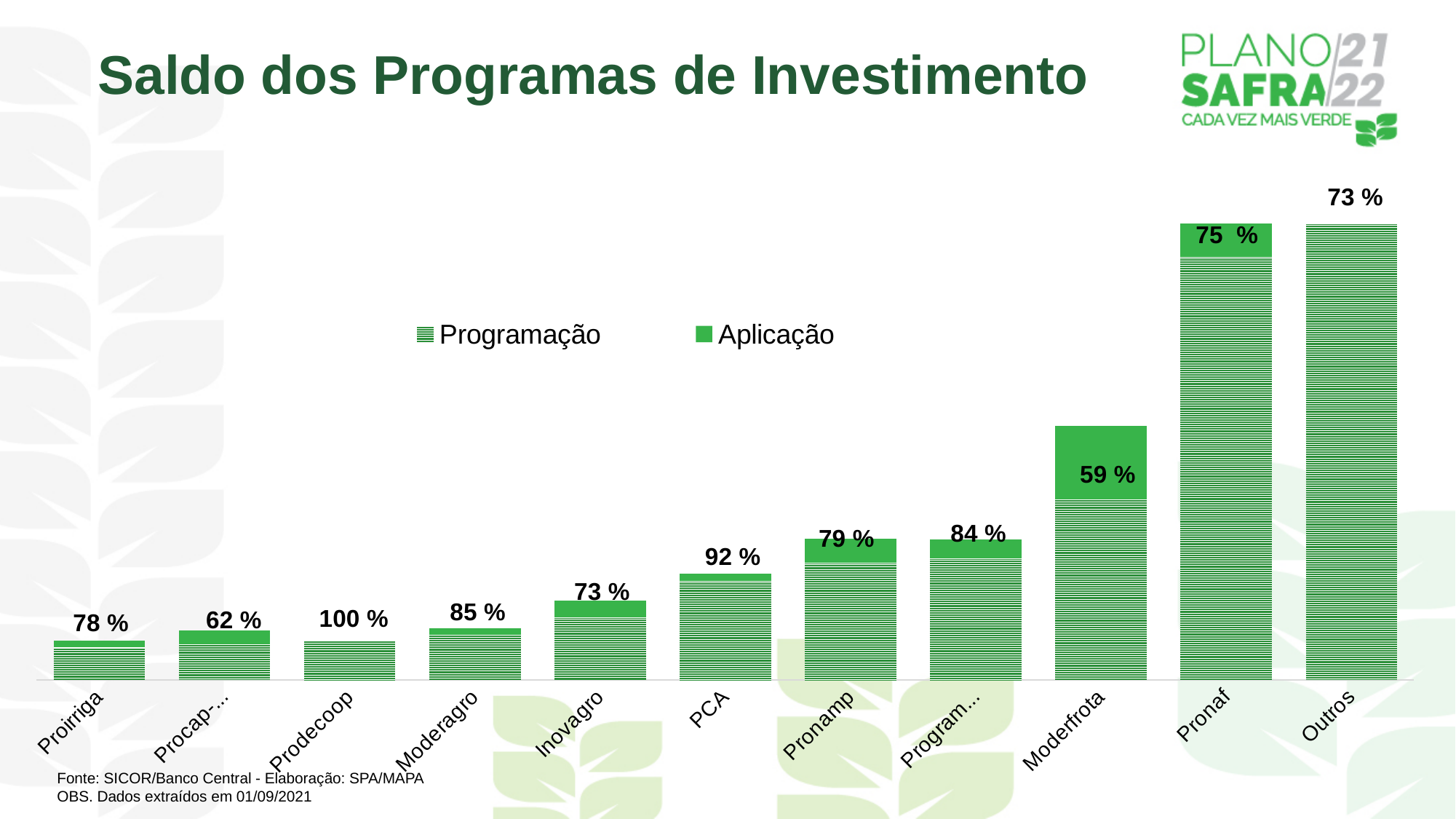
What percentage label is shown for Prodecoop? 100 % Which program has the highest percentage label? Prodecoop How many series does the legend list? 2 Which program has the lowest percentage label? Moderfrota What type of chart is shown on the slide? stacked bar chart What percentage label is shown for PCA? 92 % What percentage label is shown for Pronaf? 75 % What is the difference in percentage points between the labels for Prodecoop and Moderfrota? 41 How many programs (categories) are shown on the x axis? 11 What are the two series named in the legend? Programação and Aplicação What percentage label is shown for Moderfrota? 59 %